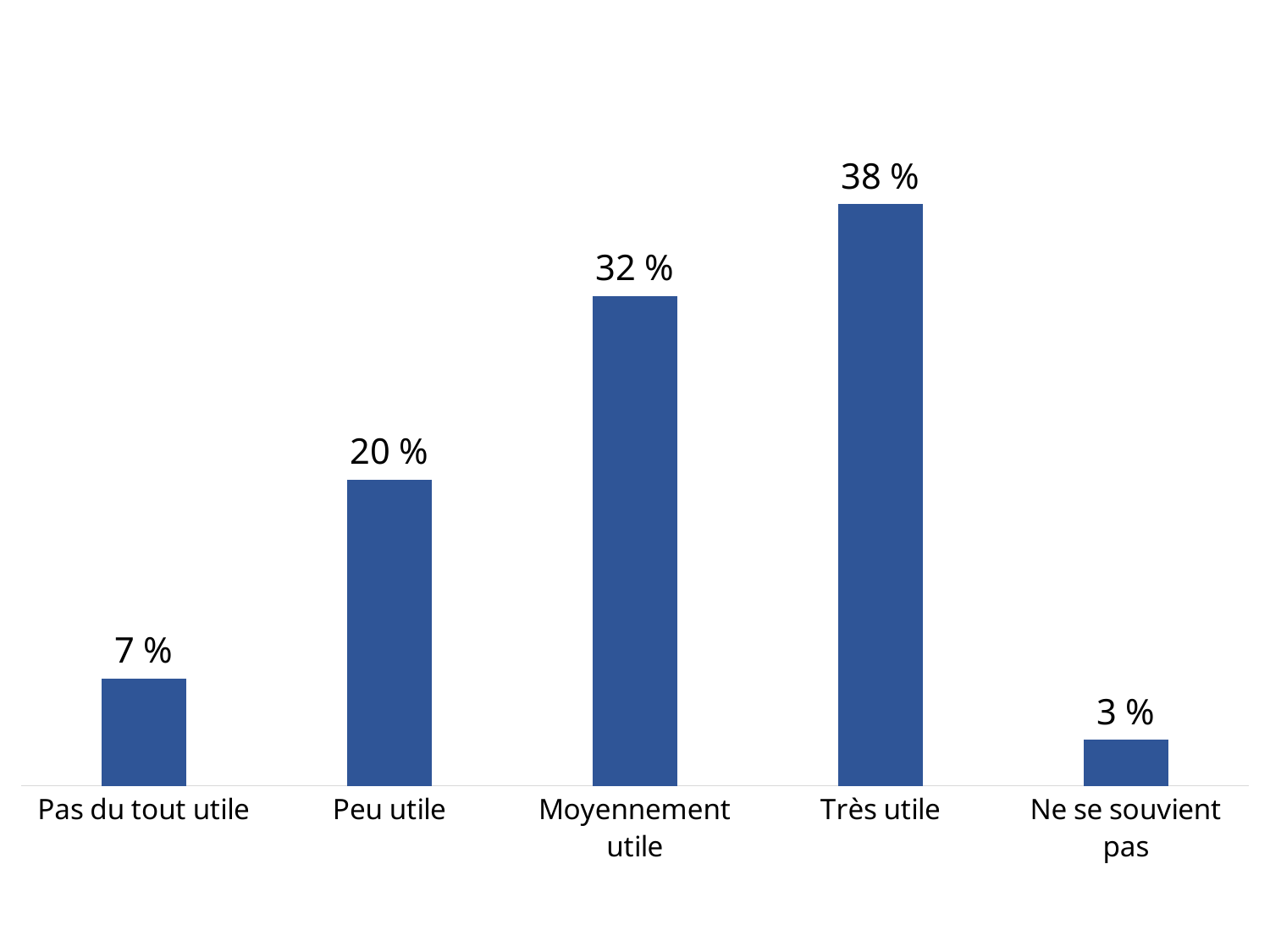
What is the value for "Moyennement utile"? 32 % What is the value for "Ne se souvient pas"? 3 % What is the difference between the values for "Peu utile" and "Pas du tout utile"? 13 % Which category has the highest value? Très utile Which is larger, the value for "Peu utile" or the value for "Moyennement utile"? Moyennement utile What is the value for "Très utile"? 38 % What colour are the bars? Blue What kind of chart is this? Bar chart What is the value for "Pas du tout utile"? 7 % How many categories are shown on the x axis? 5 What is the difference between the values for "Très utile" and "Moyennement utile"? 6 % Which category has the lowest value? Ne se souvient pas